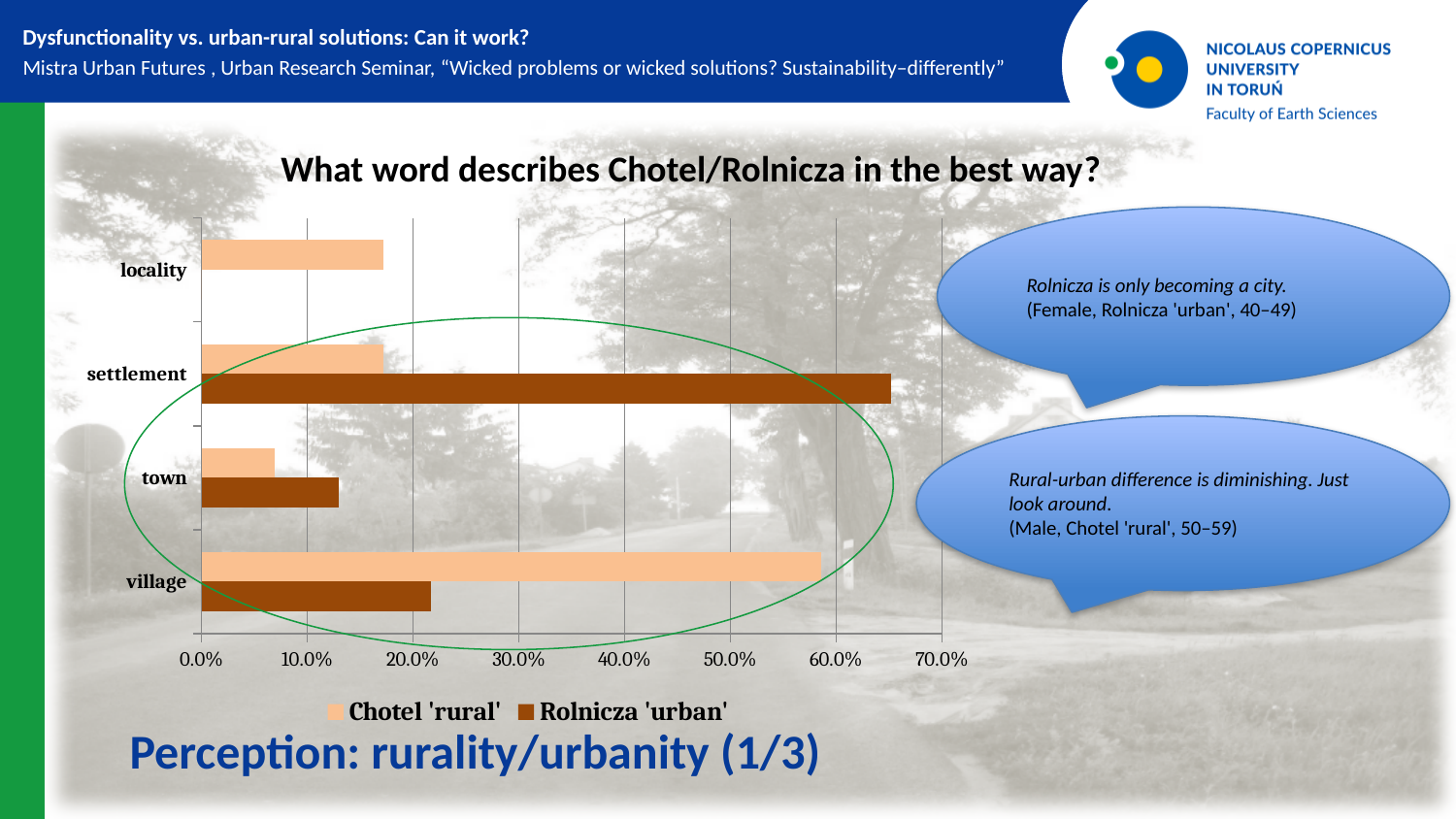
What kind of chart is shown on the slide? bar chart For the settlement category, which series has the larger value: Chotel 'rural' or Rolnicza 'urban'? Rolnicza 'urban' Is the Rolnicza 'urban' value for settlement greater or less than 60.0%? greater Is the Chotel 'rural' value for town greater or less than 10.0%? less How many categories are shown on the chart's vertical axis? 4 Which category has the highest value for the Chotel 'rural' series? village For the village category, which series has the larger value: Chotel 'rural' or Rolnicza 'urban'? Chotel 'rural' Which category has the lowest value for the Chotel 'rural' series? town Is the Chotel 'rural' value for village greater or less than 50.0%? greater What is the title of the chart? What word describes Chotel/Rolnicza in the best way? How many series does the chart legend list? 2 Which category has the highest value for the Rolnicza 'urban' series? settlement